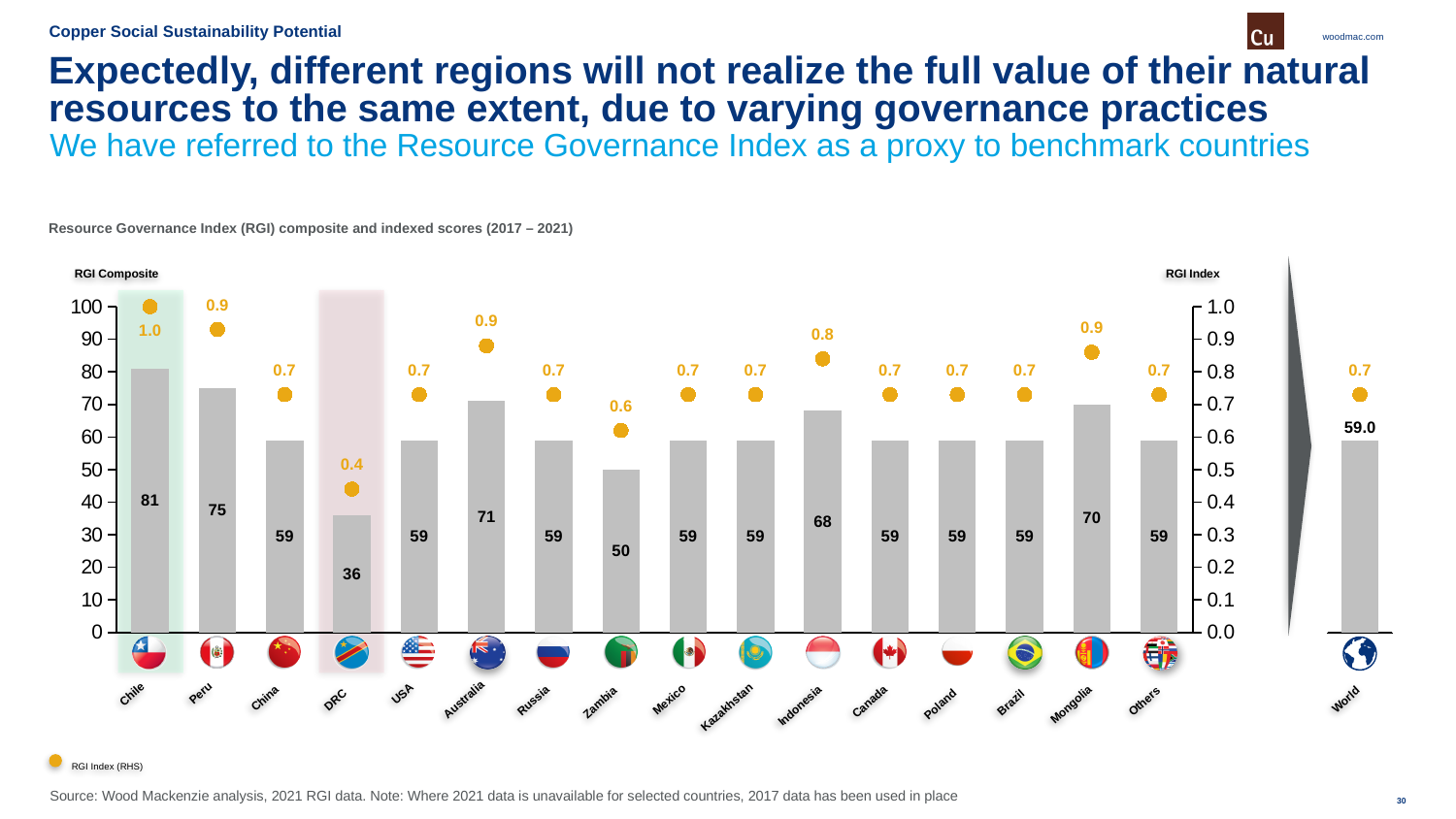
What type of chart is used to show the RGI Composite scores? Bar chart What is the RGI Composite value for DRC? 36 Which country has the lowest RGI Composite score? DRC Which has a higher RGI Composite score, Australia or Mongolia? Australia How many countries/regions are shown as bars in the main chart (excluding World)? 16 What is the RGI Composite value for Chile? 81 What is the RGI Composite value for Indonesia? 68 What is the RGI Index value for Zambia? 0.6 What is the RGI Index value for Peru? 0.9 What is the RGI Composite value shown for World? 59.0 What is the difference between the RGI Composite scores of Chile and DRC? 45 Which country has the highest RGI Composite score? Chile